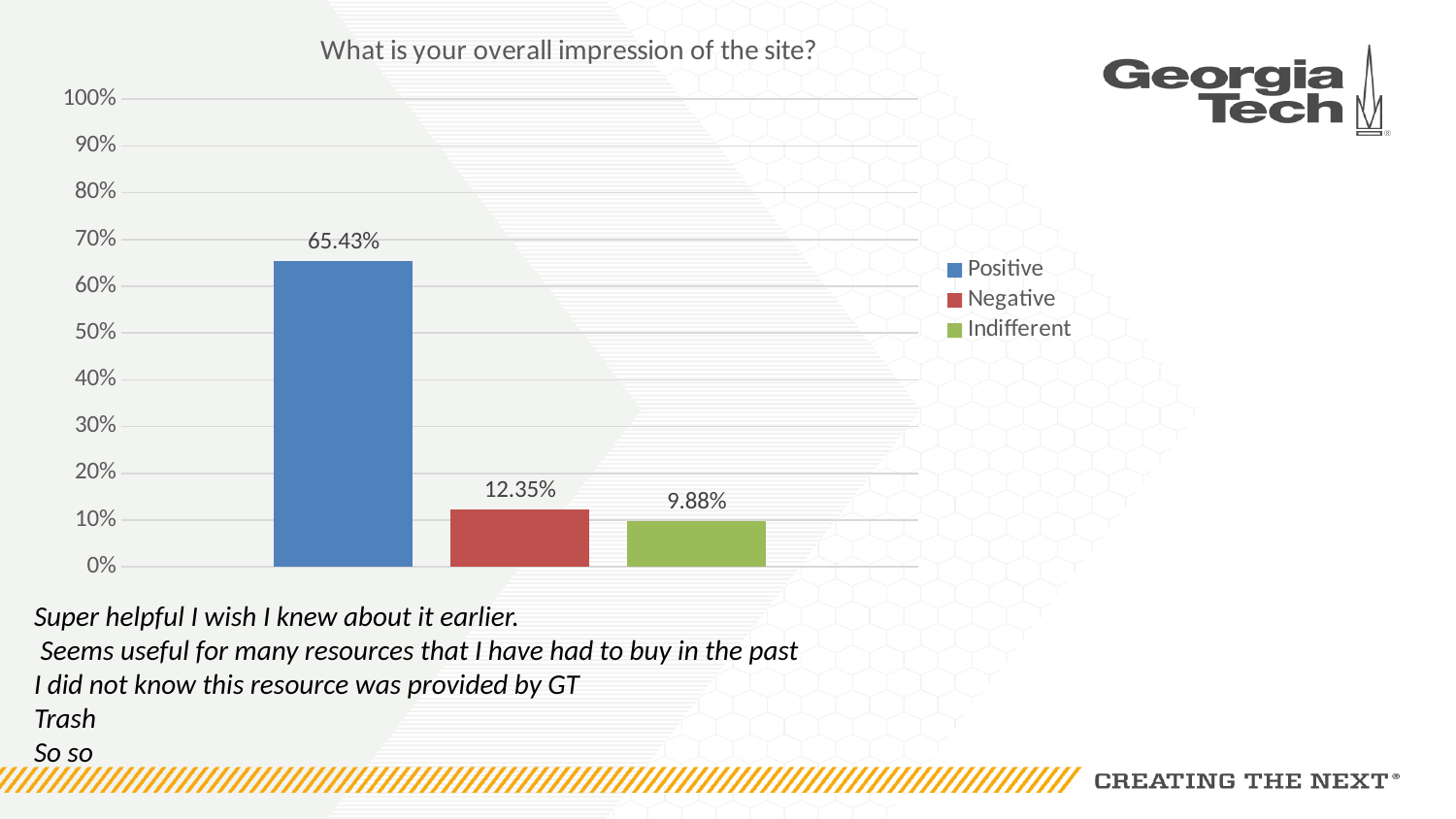
Which response category has the highest percentage? Positive Which is larger, the Negative share or the Indifferent share? Negative Which response category has the lowest percentage? Indifferent What is the title of the chart? What is your overall impression of the site? What percentage of respondents had a Negative impression of the site? 12.35% What is the difference in percentage points between the Positive and Negative responses? 53.08 What percentage of respondents were Indifferent about the site? 9.88% Is the value for Positive greater or less than 60%? greater What percentage of respondents had a Positive impression of the site? 65.43% What is the difference in percentage points between the Negative and Indifferent responses? 2.47 What kind of chart is shown on the slide? Bar chart How many series does the legend list? 3